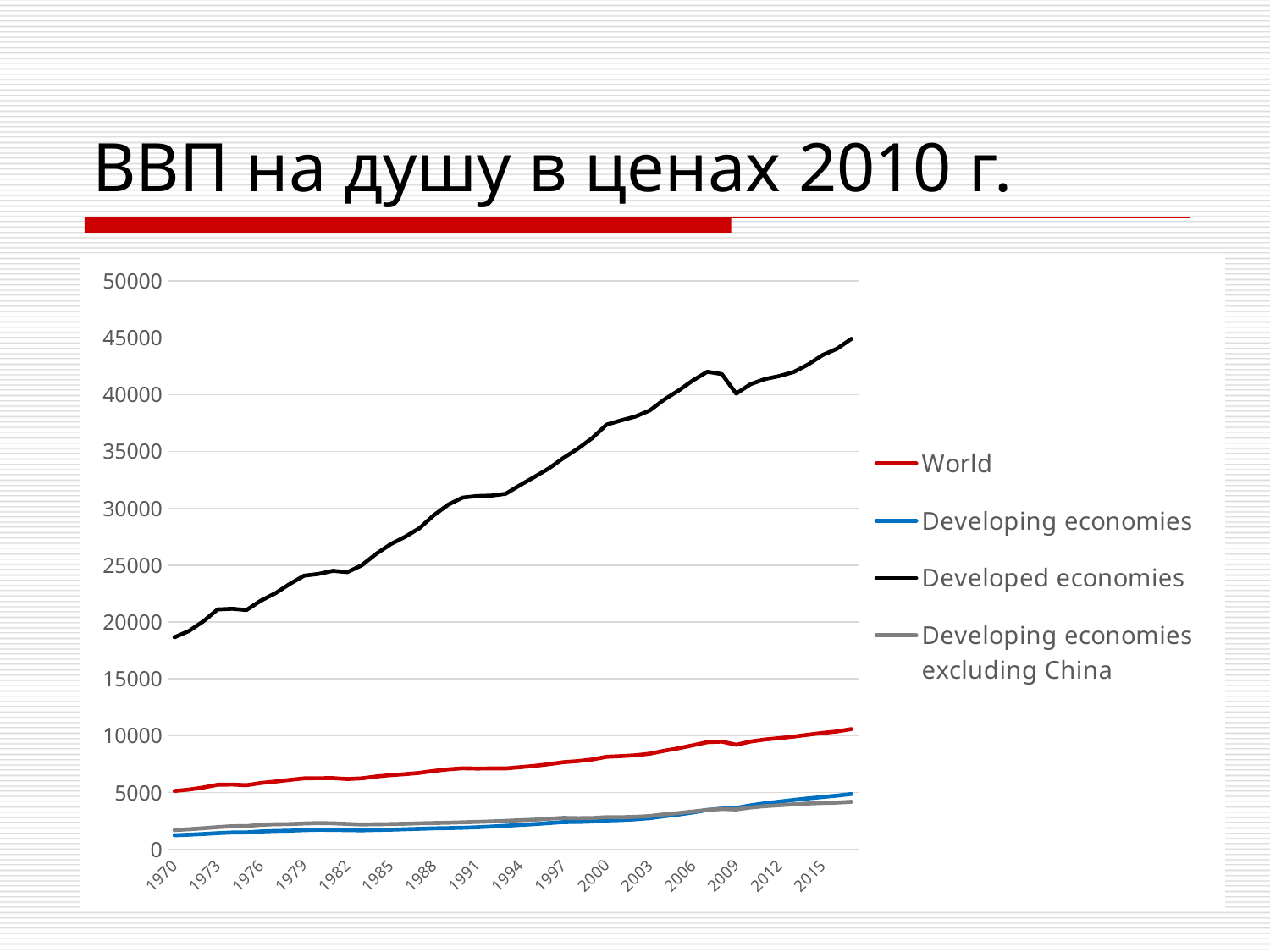
Is the value for Developed economies in 2015 greater or less than 40000? greater How many series does the legend list? 4 Which series has the lowest value in 1970? Developing economies Is the value for Developed economies in 2000 greater or less than 35000? greater Which is larger in 1970: Developing economies or Developing economies excluding China? Developing economies excluding China Which series has the highest values throughout the chart? Developed economies How many year labels are shown on the x axis? 16 What colour is the line for the World series? red Is the value for Developed economies in 1970 greater or less than 20000? less Do the values for Developed economies generally rise or fall from 1970 to 2015? rise What kind of chart is shown on the slide? line chart